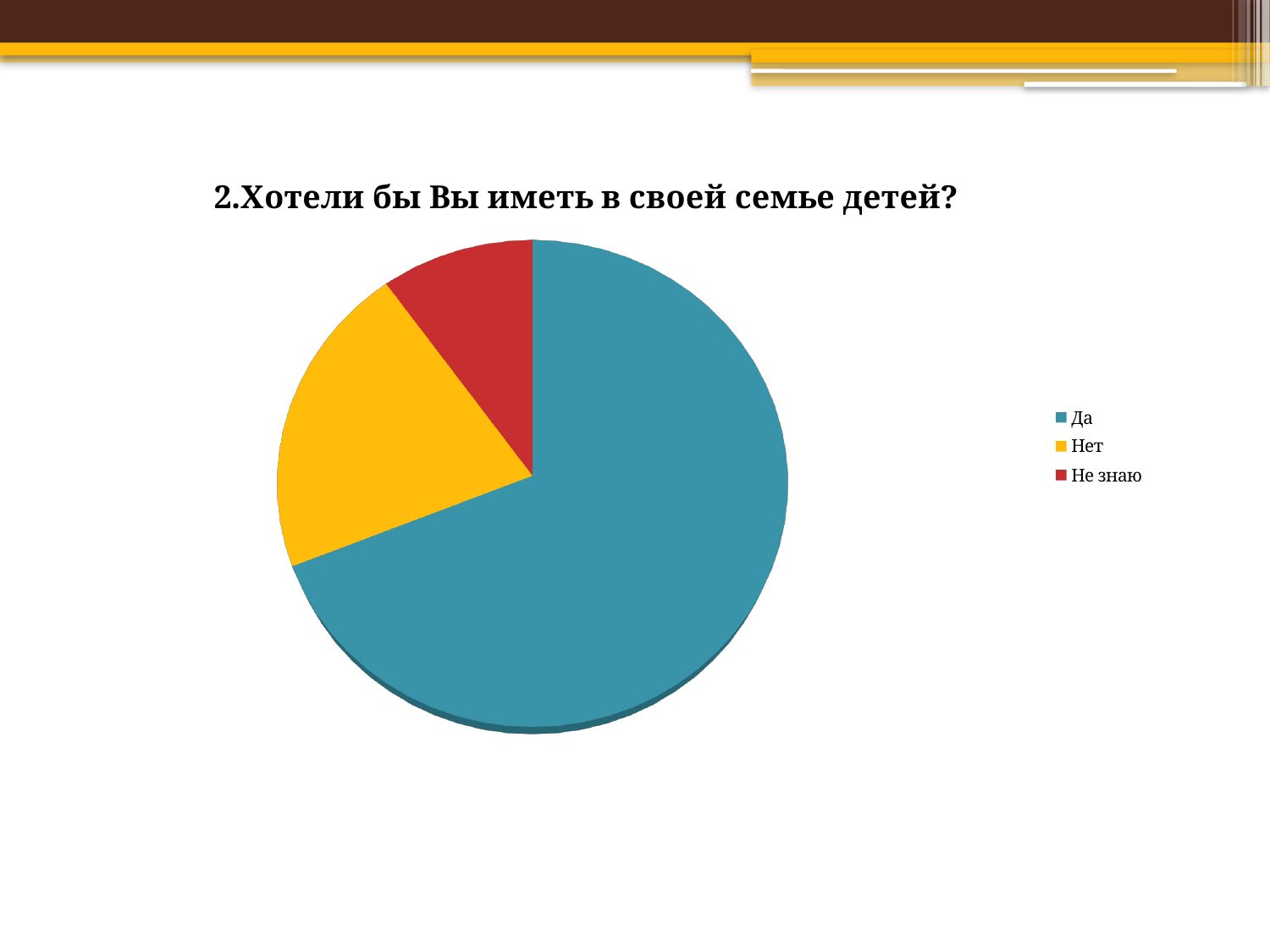
Which category has the smallest slice of the pie? Не знаю How many entries does the legend list? 3 What is the title of the chart? 2.Хотели бы Вы иметь в своей семье детей? Does the Да slice take up more or less than half of the pie? more What kind of chart is shown on the slide? pie chart Which slice is larger, Нет or Не знаю? Нет How many slices does the pie chart have? 3 What colour is the Не знаю slice? red Which category has the largest slice of the pie? Да Which slice is larger, Да or Нет? Да